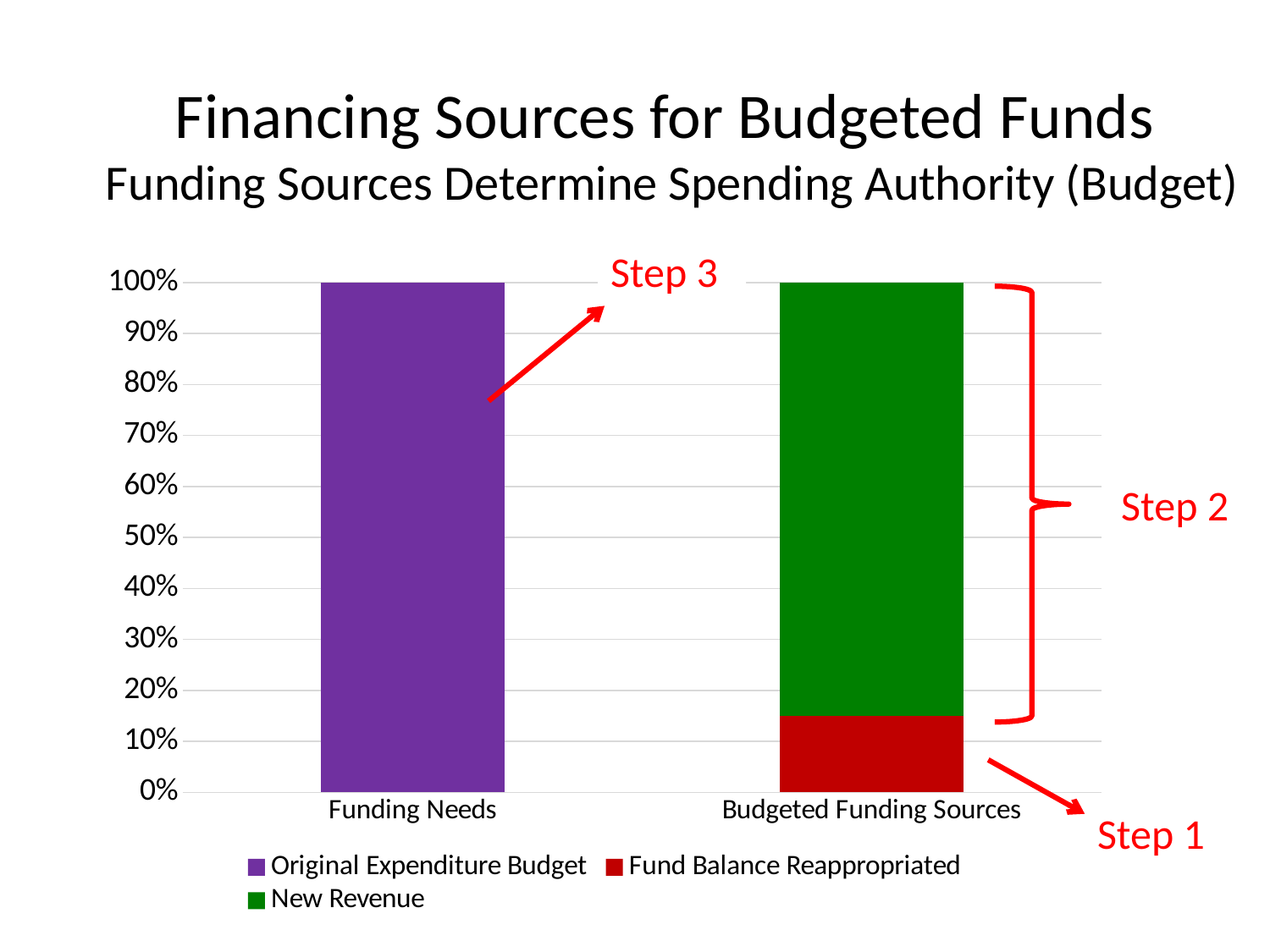
Which series is shown in purple in the chart? Original Expenditure Budget How many series does the chart's legend list? 3 What kind of chart is shown on the slide? Stacked bar chart Is the Fund Balance Reappropriated value for Budgeted Funding Sources greater or less than 10%? greater Is the New Revenue segment for Budgeted Funding Sources greater or less than 80%? greater What is the value of the Original Expenditure Budget bar for Funding Needs? 100% Which category's bar contains the Fund Balance Reappropriated segment? Budgeted Funding Sources What is the total height of the stacked bar for Budgeted Funding Sources? 100% How many categories are shown on the x axis of the chart? 2 Which series is shown in green in the chart? New Revenue Is the Fund Balance Reappropriated value for Budgeted Funding Sources greater or less than 20%? less Within the Budgeted Funding Sources bar, which segment is larger: New Revenue or Fund Balance Reappropriated? New Revenue